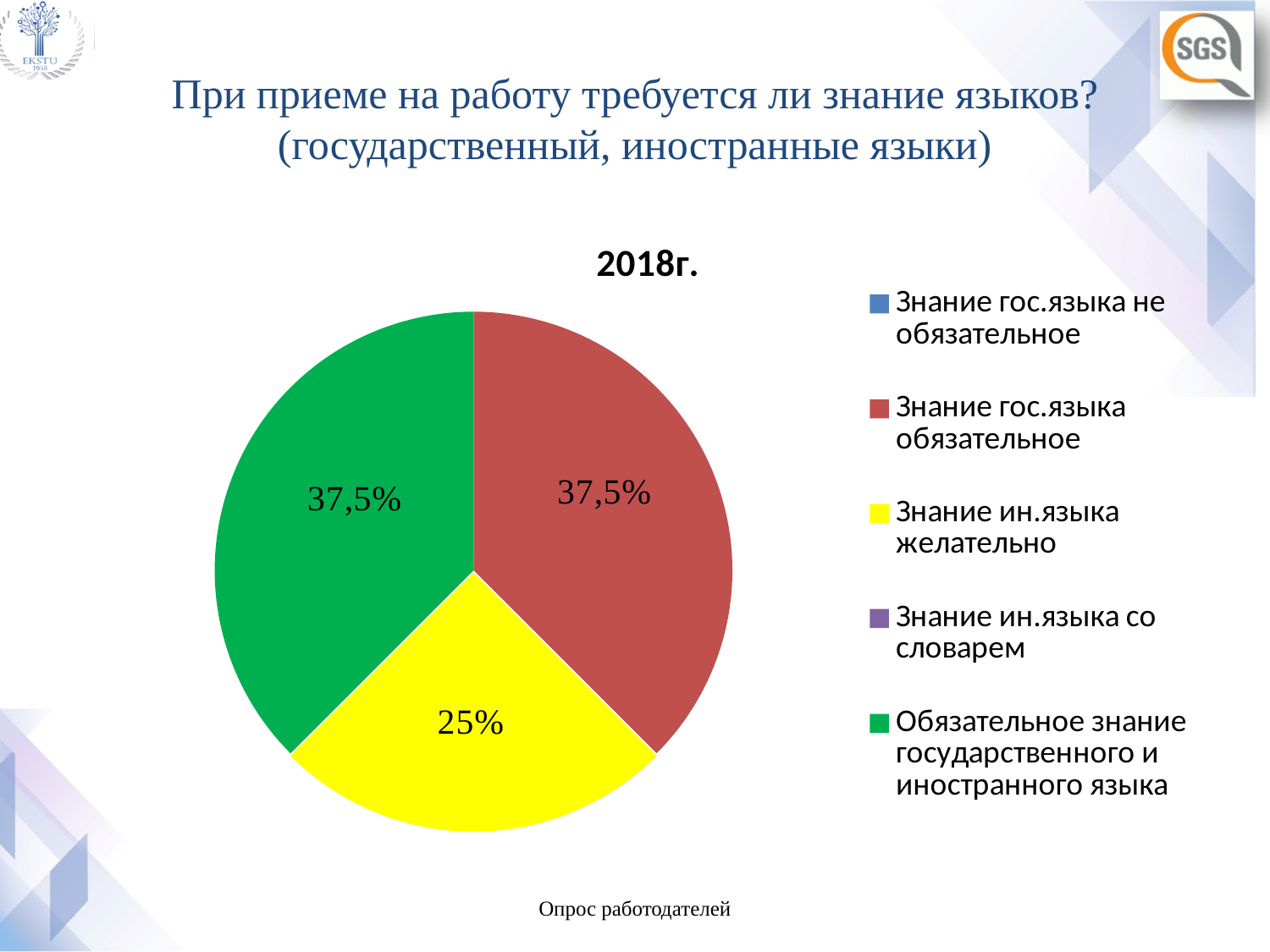
What kind of chart is shown on the slide? pie chart What is the title of the chart? 2018г. What colour is the slice for "Знание ин.языка желательно"? yellow What share of the pie is labelled for "Знание ин.языка желательно"? 25% Is the share for "Знание ин.языка желательно" greater or less than 30%? less Which category has the smallest visible slice in the pie chart? Знание ин.языка желательно What share of the pie is labelled for "Знание гос.языка обязательное"? 37,5% Which is larger: the slice for "Знание гос.языка обязательное" or the slice for "Знание ин.языка желательно"? Знание гос.языка обязательное What share of the pie is labelled for "Обязательное знание государственного и иностранного языка"? 37,5% How many slices are visible in the pie chart? 3 What is the difference between the share for "Знание гос.языка обязательное" and the share for "Знание ин.языка желательно"? 12,5% How many entries does the chart's legend list? 5